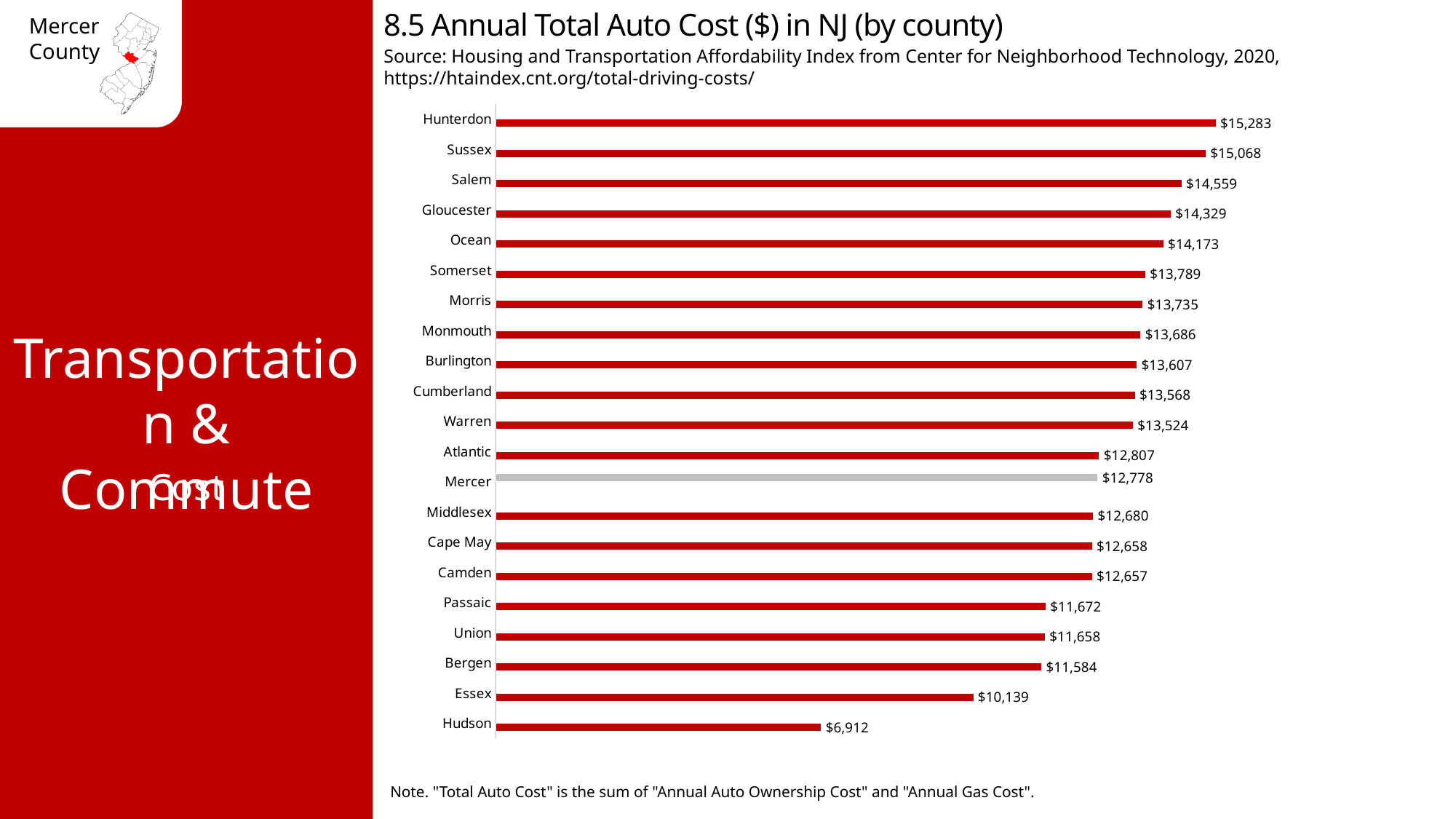
Which county has the highest annual total auto cost? Hunterdon Which county has the lowest annual total auto cost? Hudson What is the difference in annual total auto cost between Hunterdon and Hudson? $8,371 What type of chart is used on this slide? Bar chart What is the difference in annual total auto cost between Atlantic and Mercer? $29 What is the annual total auto cost for Somerset County? $13,789 What is the annual total auto cost for Mercer County? $12,778 Which county has a higher annual total auto cost, Ocean or Passaic? Ocean Which county has a higher annual total auto cost, Essex or Bergen? Bergen How many counties are shown in the chart? 21 What is the annual total auto cost for Hudson County? $6,912 Which county's bar is shown in gray instead of red? Mercer